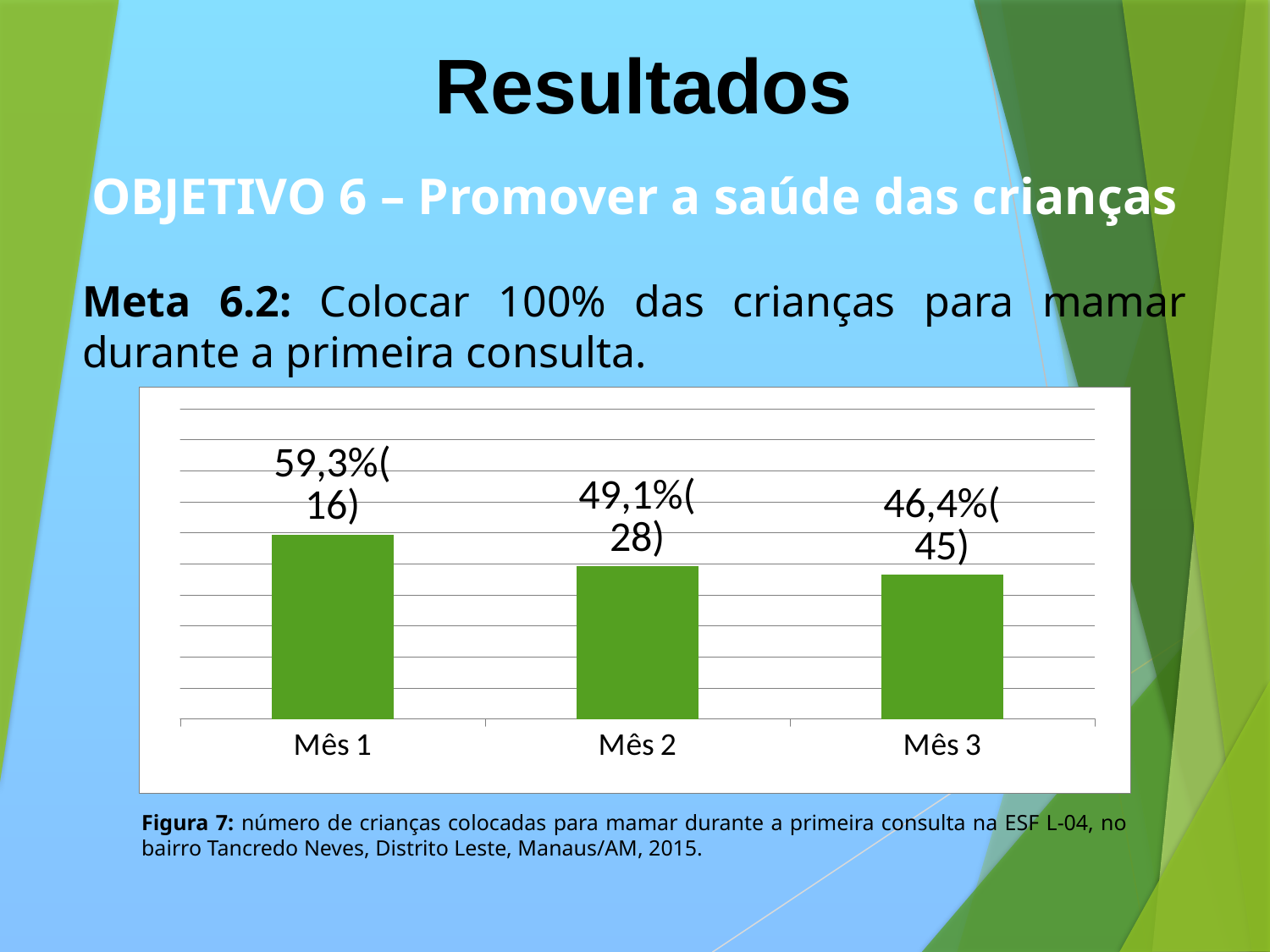
What is the difference between the counts in parentheses for Mês 3 and Mês 1? 29 What is the data label shown for Mês 3? 46,4%(45) Do the percentages rise or fall from Mês 1 to Mês 3? Fall What is the data label shown for Mês 1? 59,3%(16) What is the data label shown for Mês 2? 49,1%(28) What is the difference in percentage points between Mês 1 and Mês 2? 10,2 Which is larger, the percentage for Mês 2 or for Mês 3? Mês 2 What kind of chart is shown on the slide? Bar chart What percentage is shown for Mês 3? 46,4% How many months (categories) are shown on the x axis? 3 Which month has the lowest bar? Mês 3 Which month has the highest bar? Mês 1